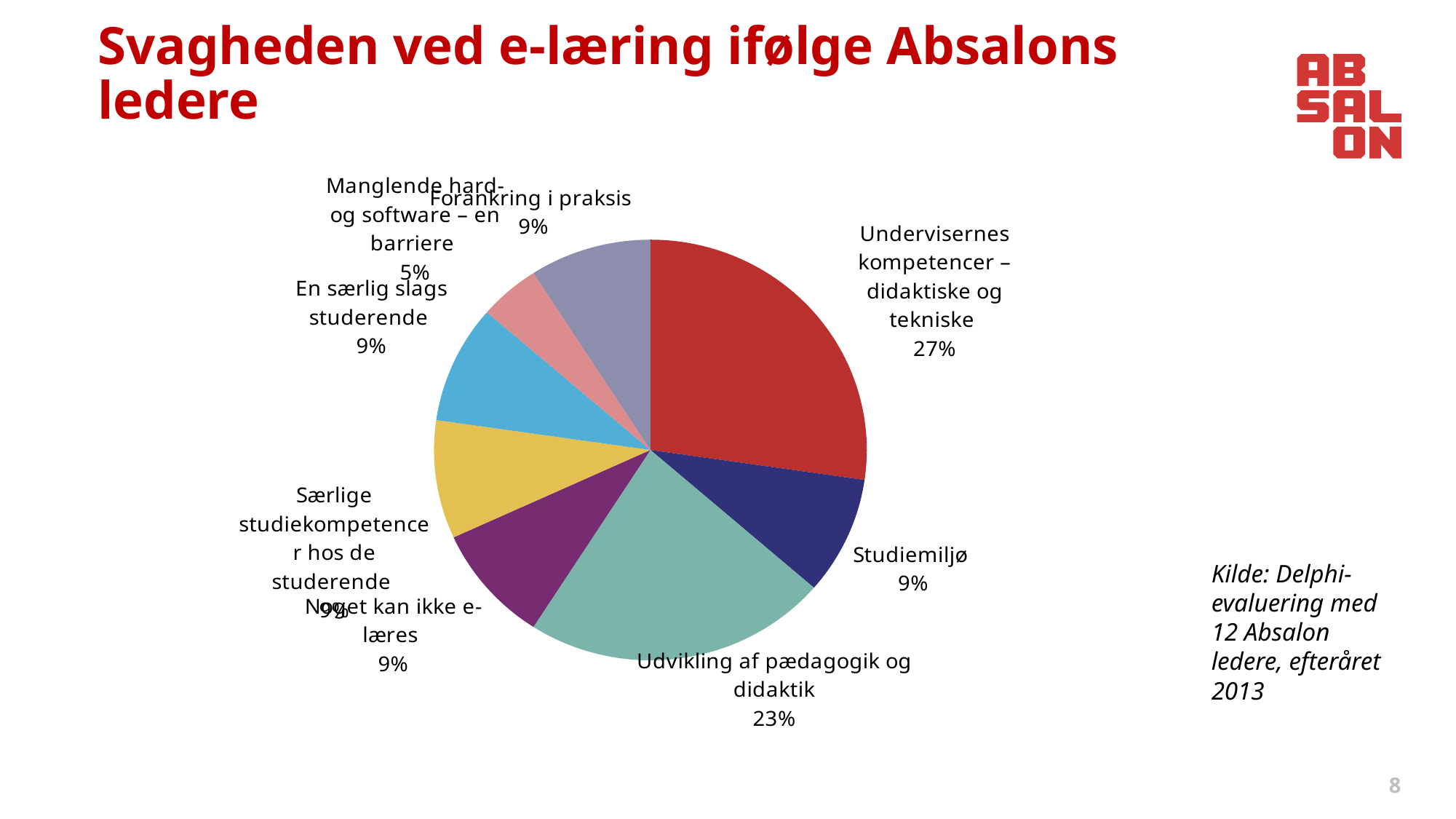
How many slices does the pie chart have? 8 What is the value shown for "Manglende hard- og software – en barriere"? 5% What is the title of the slide containing the pie chart? Svagheden ved e-læring ifølge Absalons ledere What share of the pie does "Udvikling af pædagogik og didaktik" represent? 23% What kind of chart is shown on the slide? pie chart What share of the pie does "Undervisernes kompetencer – didaktiske og tekniske" represent? 27% Which is larger: the share for "Noget kan ikke e-læres" or the share for "Manglende hard- og software – en barriere"? Noget kan ikke e-læres What is the difference between the shares for "Undervisernes kompetencer – didaktiske og tekniske" and "Udvikling af pædagogik og didaktik"? 4% Which category has the smallest slice of the pie? Manglende hard- og software – en barriere Which category has the largest slice of the pie? Undervisernes kompetencer – didaktiske og tekniske What is the value shown for "Studiemiljø"? 9% What is the value shown for "Forankring i praksis"? 9%